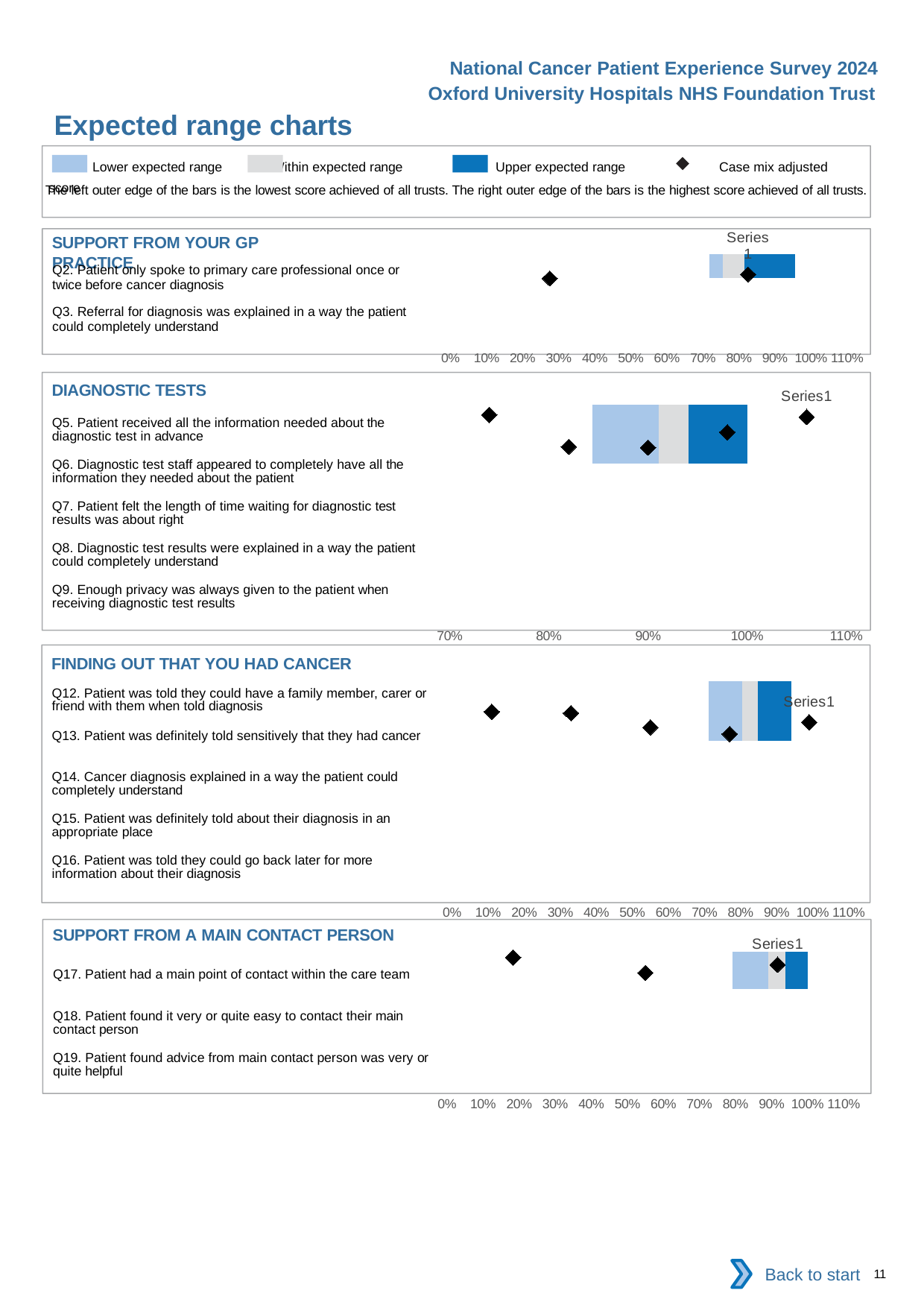
What kind of chart is used for the expected ranges on this slide? bar chart How many expected range charts are shown on the slide? 4 How many questions are listed in the DIAGNOSTIC TESTS chart? 5 In the FINDING OUT THAT YOU HAD CANCER chart, is the right edge of the expected range bar greater or less than 100%? less According to the legend, what marker shape represents the case mix adjusted score? diamond How many questions are listed in the FINDING OUT THAT YOU HAD CANCER chart? 5 How many entries does the legend at the top of the slide list? 4 Which chart on the slide has an x axis that starts at 70% rather than 0%? DIAGNOSTIC TESTS In the DIAGNOSTIC TESTS chart, is the left edge of the expected range bar greater or less than 80%? greater